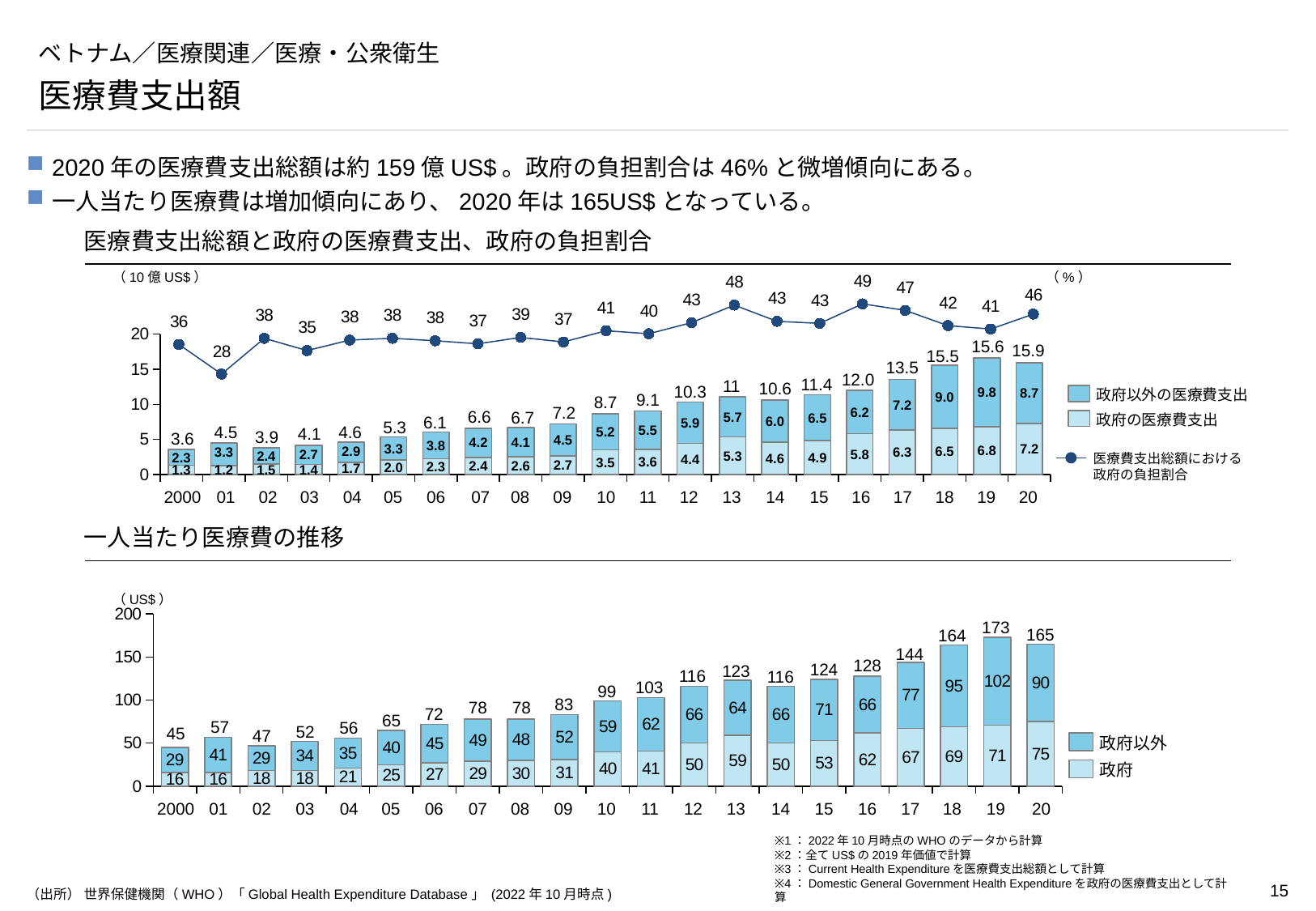
In the top chart, in which year is the government share line at its highest? 16 In the bottom chart, which is larger, the total for 2017 or the total for 2018? 2018 In the top chart, what is the government share (政府の負担割合) shown for 2013? 48 How many years are shown on the x axis of the bottom chart? 21 What kind of chart is the bottom chart (一人当たり医療費の推移)? Stacked bar chart How many series does the legend of the top chart list? 3 In the top chart, in which year is the government share line at its lowest? 01 In the bottom chart, what is the difference between 政府以外 and 政府 for 2020? 15 In the top chart (医療費支出総額と政府の医療費支出、政府の負担割合), what is the total health expenditure labeled for 2020? 15.9 In the bottom chart, which year has the highest total per-capita health expenditure? 19 In the top chart, what is the value of 政府の医療費支出 for 2020? 7.2 In the bottom chart (一人当たり医療費の推移), what is the total per-capita health expenditure for 2019? 173